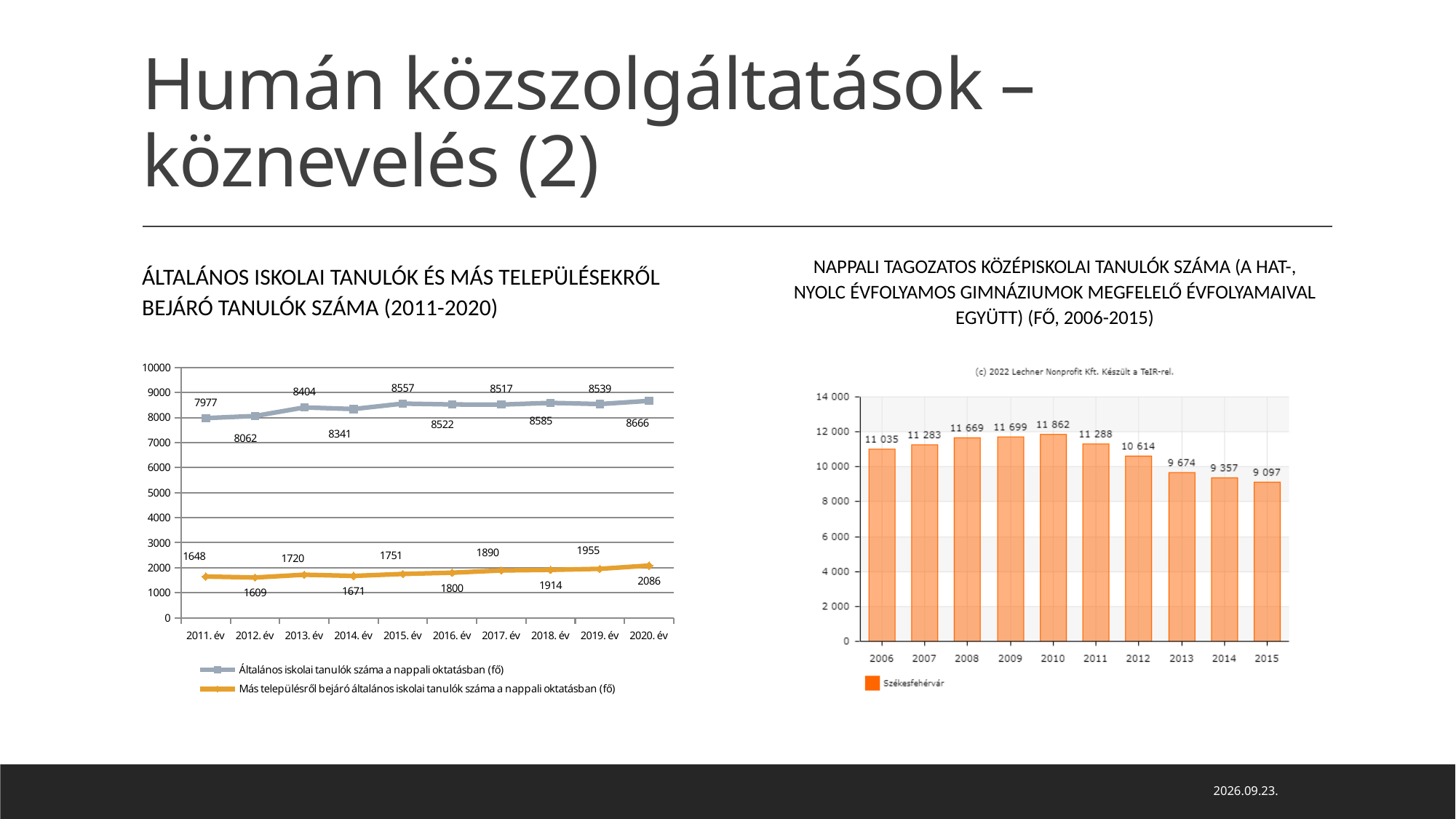
In the right chart, how many years (bars) are shown? 10 In the left chart (Általános iskolai tanulók és más településekről bejáró tanulók száma), what is the value of 'Általános iskolai tanulók száma a nappali oktatásban (fő)' for 2020. év? 8666 In the right chart, what is the difference between the values for 2012 and 2013? 940 In the left chart, does the 'Más településről bejáró' series generally rise or fall from 2011. év to 2020. év? rise In the right chart, which year has the highest value? 2010 In the left chart, how many series does the legend list? 2 In the left chart, which year has the lowest value for 'Más településről bejáró általános iskolai tanulók száma a nappali oktatásban (fő)'? 2012. év In the right chart (Nappali tagozatos középiskolai tanulók száma), what is the value for 2010? 11 862 What kind of chart is the left chart? line chart In the left chart, what is the difference between the 2020. év and 2011. év values of 'Általános iskolai tanulók száma a nappali oktatásban (fő)'? 689 In the left chart, what is the value of 'Más településről bejáró általános iskolai tanulók száma a nappali oktatásban (fő)' for 2015. év? 1751 In the right chart, which year has the lowest value? 2015